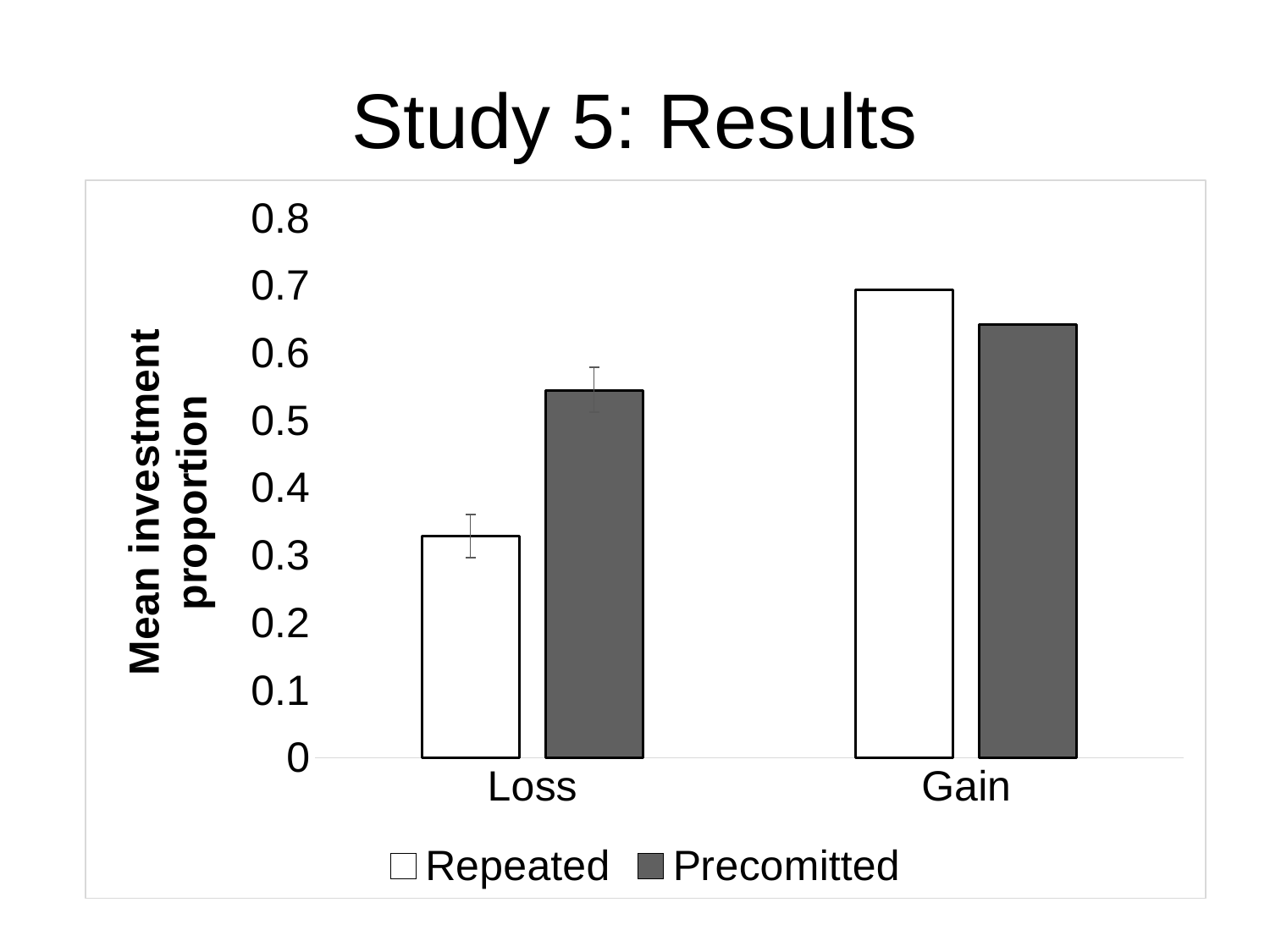
Which bar is the tallest in the chart? Repeated in Gain What is the label of the y axis? Mean investment proportion Is the Precomitted value for Gain greater or less than 0.7? less In the Loss condition, which series has the larger value, Repeated or Precomitted? Precomitted Which bar is the shortest in the chart? Repeated in Loss Is the Precomitted value for Loss greater or less than 0.5? greater How many series does the legend list? 2 Is the Repeated value for Loss greater or less than 0.4? less What kind of chart is shown on the slide? bar chart In the Gain condition, which series has the larger value, Repeated or Precomitted? Repeated How many categories are shown on the x axis? 2